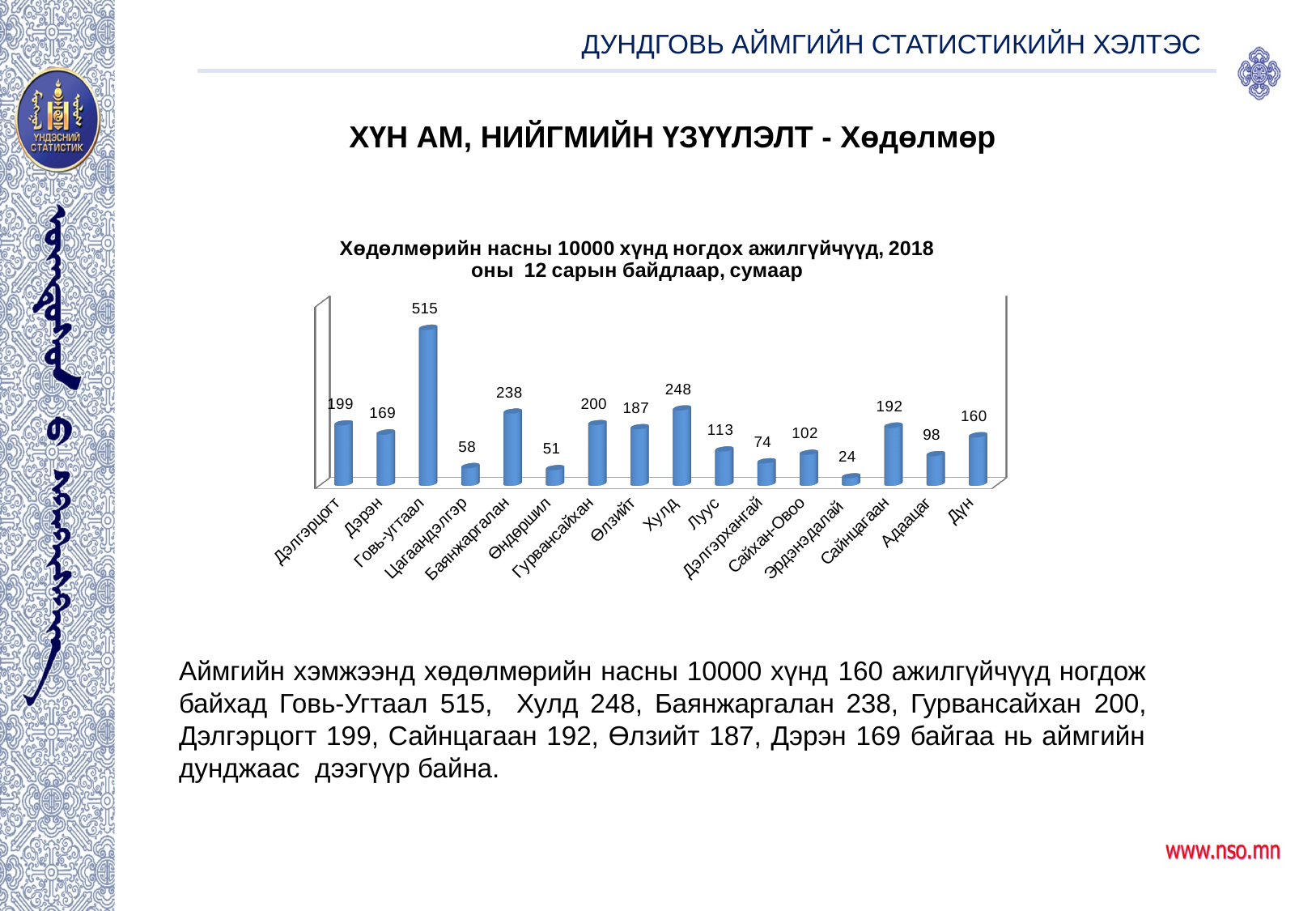
What is the value for Дүн? 160 What kind of chart is this? bar chart What is the difference between the values for Хулд and Баянжаргалан? 10 Which category has the lowest value? Эрдэнэдалай Which category has the highest value? Говь-Угтаал What is the value for Эрдэнэдалай? 24 How many categories are shown on the x axis? 16 What is the value for Говь-Угтаал? 515 What is the difference between the values for Говь-Угтаал and Дүн? 355 Which is larger, the value for Дэлгэрцогт or the value for Дэрэн? Дэлгэрцогт What is the value for Сайнцагаан? 192 What is the title of the chart? Хөдөлмөрийн насны 10000 хүнд ногдох ажилгүйчүүд, 2018 оны 12 сарын байдлаар, сумаар